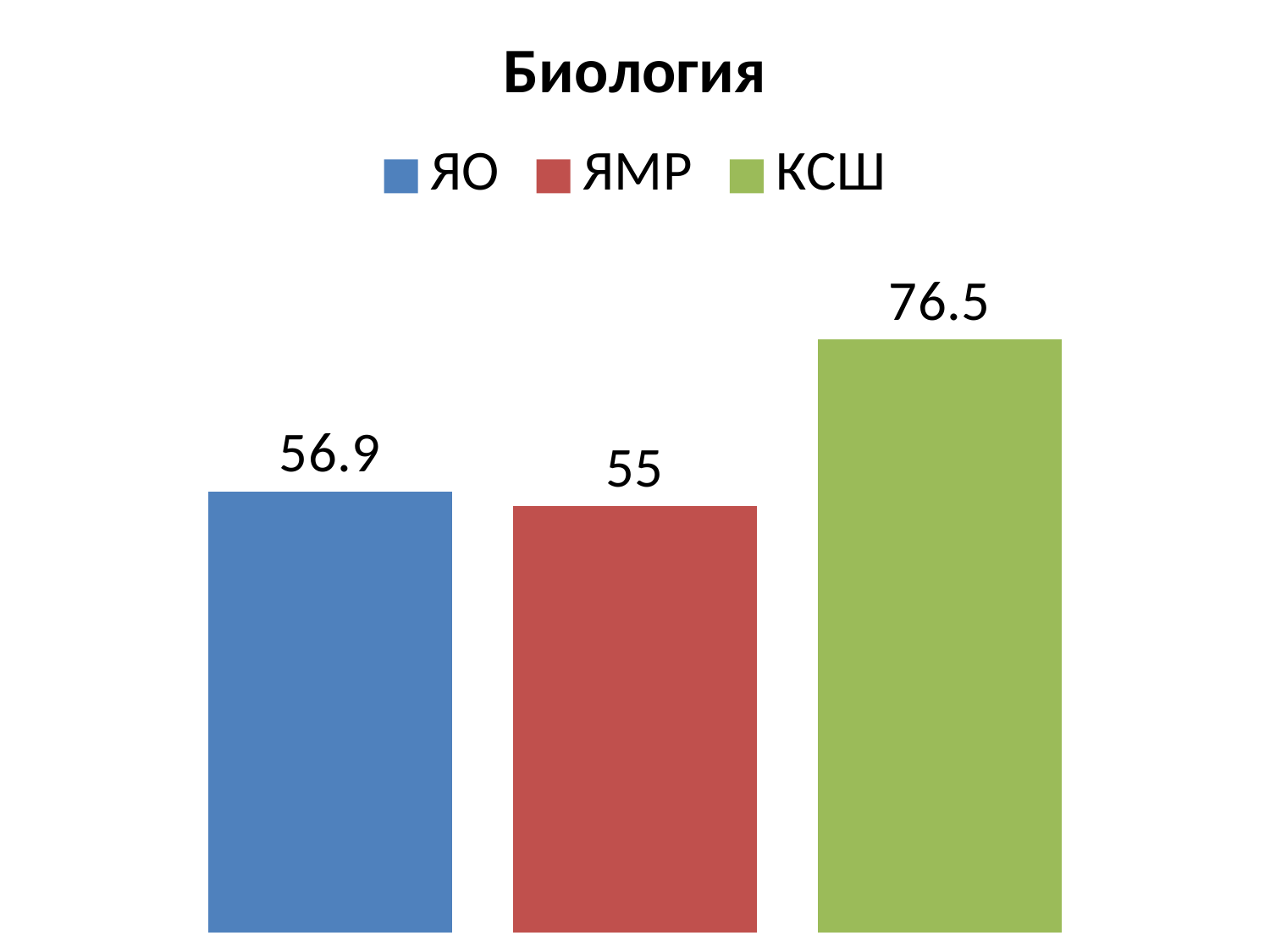
What is the difference between the values for ЯО and ЯМР? 1.9 What is the value for ЯО in the Биология chart? 56.9 What is the value for ЯМР in the Биология chart? 55 How many series does the legend list? 3 Which is larger, the value for КСШ or the value for ЯМР? КСШ Which series has the highest value in the Биология chart? КСШ What is the value for КСШ in the Биология chart? 76.5 Which series has the lowest value in the Биология chart? ЯМР What kind of chart is shown on the slide? Bar chart What is the difference between the values for КСШ and ЯО? 19.6 How many bars are shown in the Биология chart? 3 What is the title of the chart? Биология